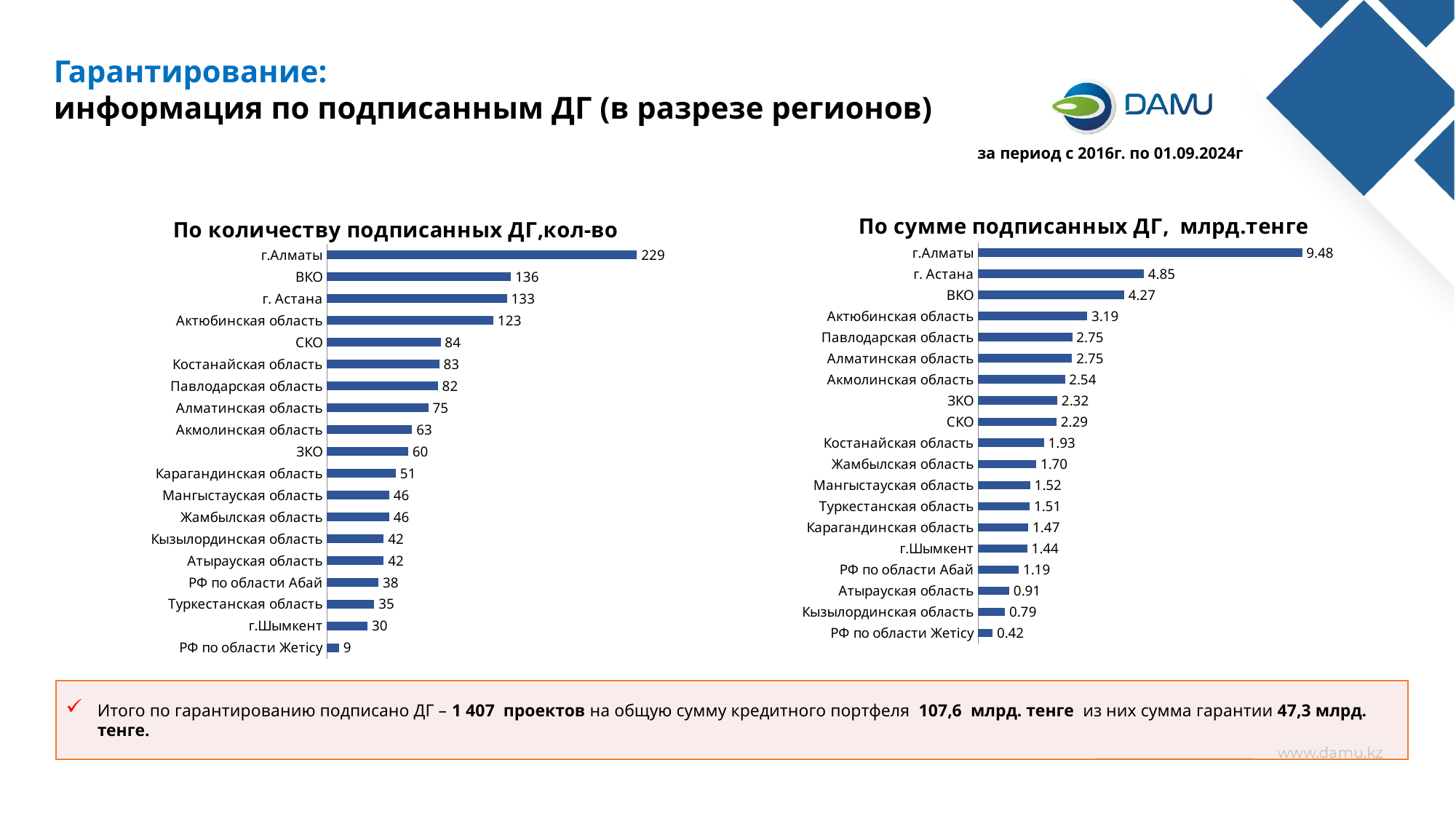
In the chart 'По сумме подписанных ДГ, млрд.тенге', what is the value for Костанайская область? 1.93 In the chart 'По количеству подписанных ДГ,кол-во', how many categories are shown? 19 What type of chart is 'По сумме подписанных ДГ, млрд.тенге'? Bar chart In the chart 'По количеству подписанных ДГ,кол-во', what is the difference between the values for ВКО and г. Астана? 3 In the chart 'По сумме подписанных ДГ, млрд.тенге', what is the value for г. Астана? 4.85 In the chart 'По сумме подписанных ДГ, млрд.тенге', which category has the highest value? г.Алматы In the chart 'По сумме подписанных ДГ, млрд.тенге', what is the difference between the values for г.Алматы and ВКО? 5.21 In the chart 'По количеству подписанных ДГ,кол-во', what is the value for г.Алматы? 229 In the chart 'По количеству подписанных ДГ,кол-во', what is the value for Актюбинская область? 123 In the chart 'По количеству подписанных ДГ,кол-во', which category has the lowest value? РФ по области Жетісу What is the title of the chart on the left side of the slide? По количеству подписанных ДГ,кол-во In the chart 'По сумме подписанных ДГ, млрд.тенге', which is larger: the value for ЗКО or the value for Жамбылская область? ЗКО